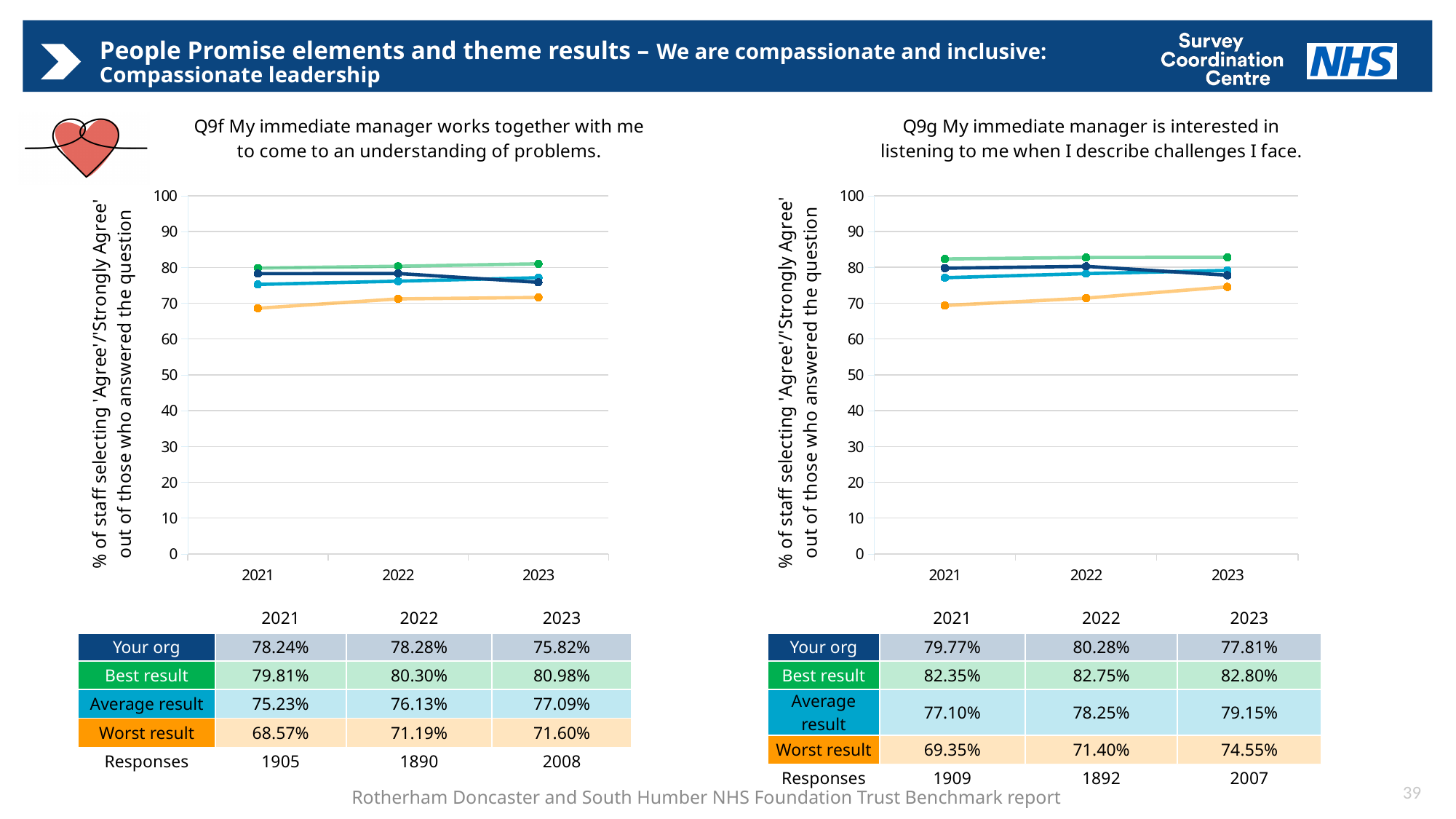
In the Q9g chart (right), what is the Best result value for 2021? 82.35% What kind of chart is used for Q9f on the left of the slide? Line chart In the Q9g chart (right), how many responses were recorded for 2023? 2007 In the Q9g chart (right), in which year is the Worst result lowest? 2021 In the Q9f chart (left), what is the Your org value for 2023? 75.82% In the Q9g chart (right), which is larger in 2022: Your org or Average result? Your org In the Q9f chart (left), is the Your org value for 2021 greater or less than 70? greater In the Q9f chart (left), does the Worst result line rise or fall from 2021 to 2023? Rise In the Q9f chart (left), in which year is the Best result highest? 2023 How many years are plotted along the x axis of the Q9g chart (right)? 3 How many data series are plotted in the Q9g chart (right)? 4 In the Q9f chart (left), what is the difference between the Best result and Your org values in 2023? 5.16 percentage points